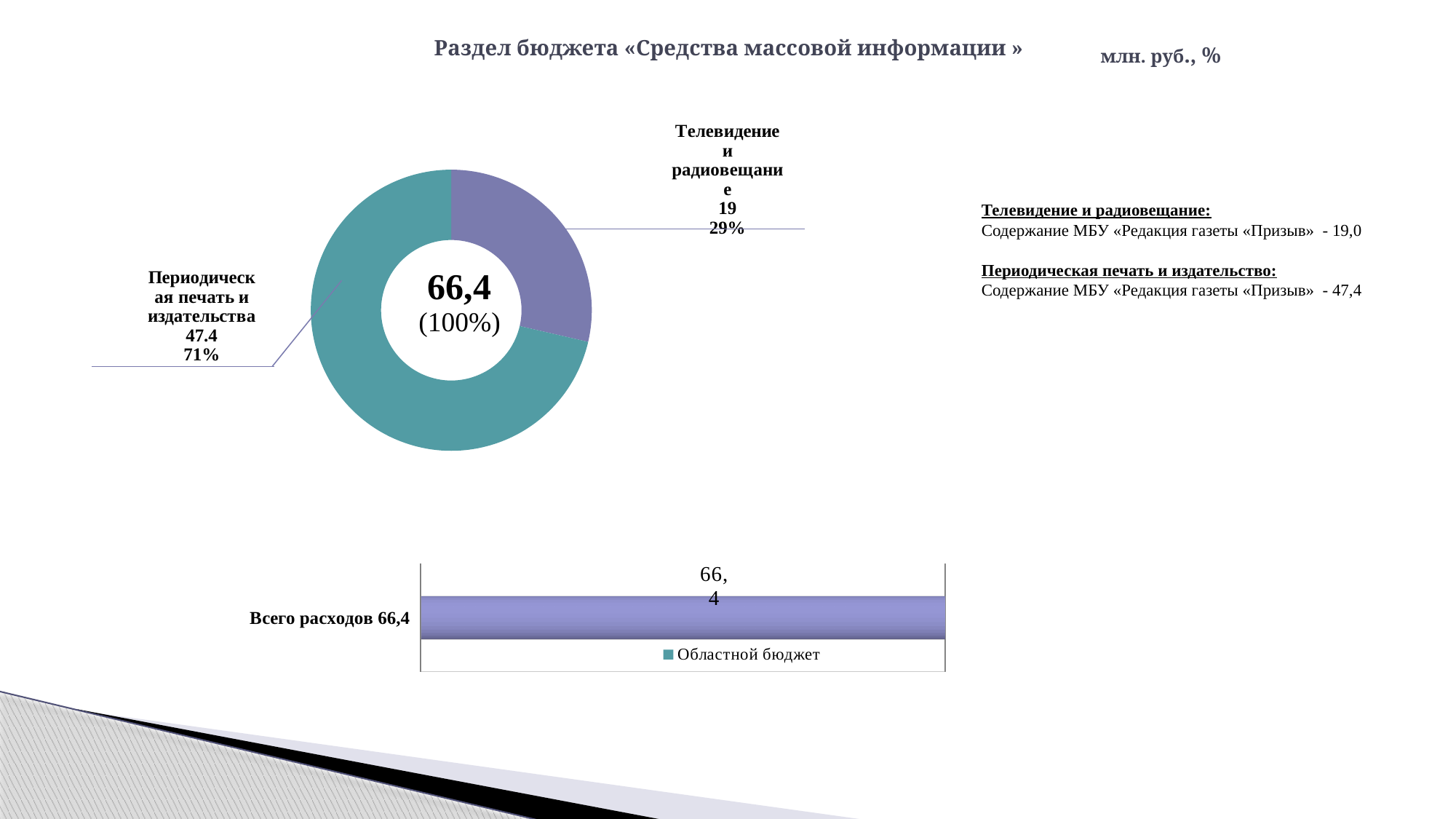
On the doughnut chart at the top of the slide, which category has the smallest value? Телевидение и радиовещание On the doughnut chart at the top of the slide, what percentage share does «Периодическая печать и издательства» have? 71% On the doughnut chart at the top of the slide, what value is shown for «Телевидение и радиовещание»? 19 On the doughnut chart at the top of the slide, what value is shown for «Периодическая печать и издательства»? 47.4 On the doughnut chart at the top of the slide, which category has the largest value? Периодическая печать и издательства On the bar chart at the bottom of the slide, what series does the legend list? Областной бюджет On the doughnut chart at the top of the slide, what is the difference between the values for «Периодическая печать и издательства» and «Телевидение и радиовещание»? 28.4 What total value is printed in the centre of the doughnut chart at the top of the slide? 66,4 On the bar chart at the bottom of the slide, what value is shown for «Всего расходов»? 66,4 What kind of chart is shown at the bottom of the slide? Bar chart On the doughnut chart at the top of the slide, what percentage share does «Телевидение и радиовещание» have? 29% On the doughnut chart at the top of the slide, how many categories are shown? 2